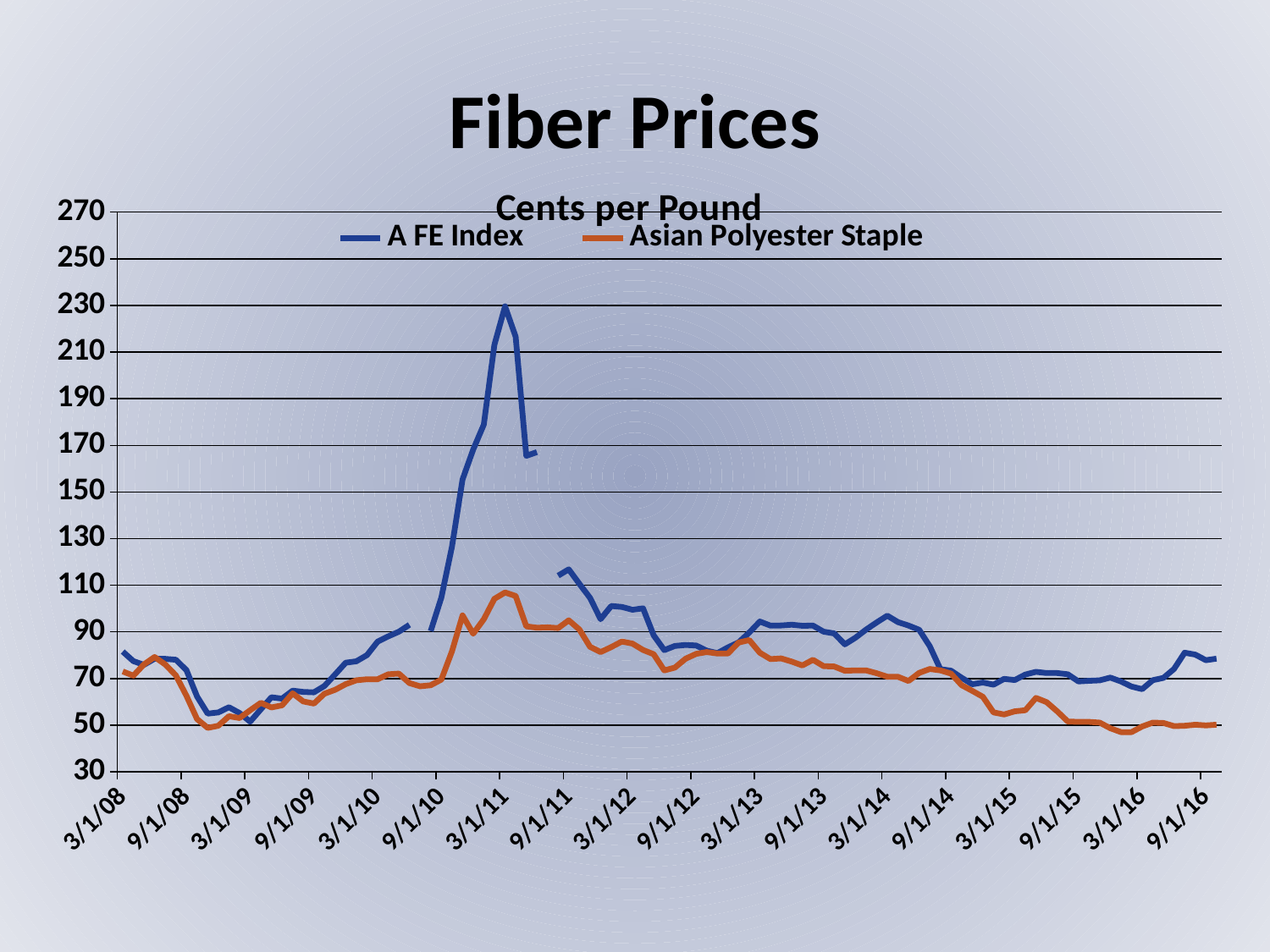
What is the title of the chart? Cents per Pound Is the peak value of Asian Polyester Staple greater or less than 90? greater What unit is given in the chart's subtitle? Cents per Pound What kind of chart is shown on the slide? line chart Near which x-axis label does the A FE Index reach its peak? 3/1/11 Is the peak value of the A FE Index greater or less than 210? greater Is the value of Asian Polyester Staple at 9/1/16 greater or less than 70? less At 3/1/15, which series has the higher value, A FE Index or Asian Polyester Staple? A FE Index Does the Asian Polyester Staple series rise or fall between 3/1/13 and 3/1/16? fall How many series does the legend list? 2 Which series reaches the highest value on the chart? A FE Index